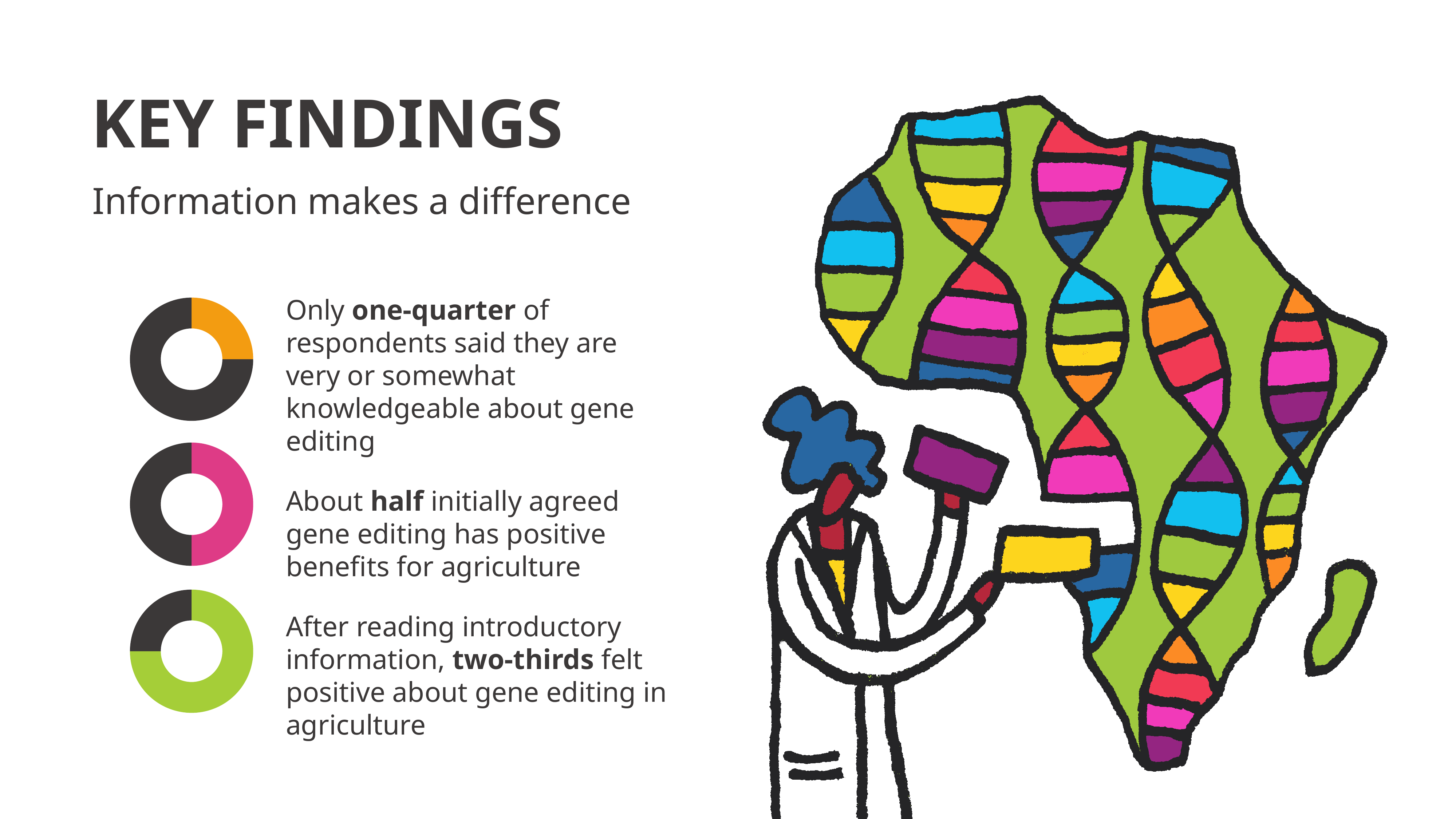
Is the highlighted share in the top donut chart greater or less than 50%? less How many donut charts are shown on the slide? 3 Which donut chart shows the smallest highlighted share: the top, middle or bottom one? top In the top donut chart, what share of respondents said they are very or somewhat knowledgeable about gene editing? one-quarter Is the highlighted share in the bottom donut chart greater or less than 50%? greater Is the highlighted share in the bottom donut chart larger or smaller than the highlighted share in the top donut chart? larger In the middle donut chart, what share of respondents initially agreed gene editing has positive benefits for agriculture? half What kind of charts are shown on the left side of the slide next to the key findings text? Donut charts What colour is the highlighted segment in the bottom donut chart? Green In the bottom donut chart, what share of respondents felt positive about gene editing in agriculture after reading introductory information? two-thirds What colour is the highlighted segment in the top donut chart? Orange Which donut chart shows the largest highlighted share: the top, middle or bottom one? bottom